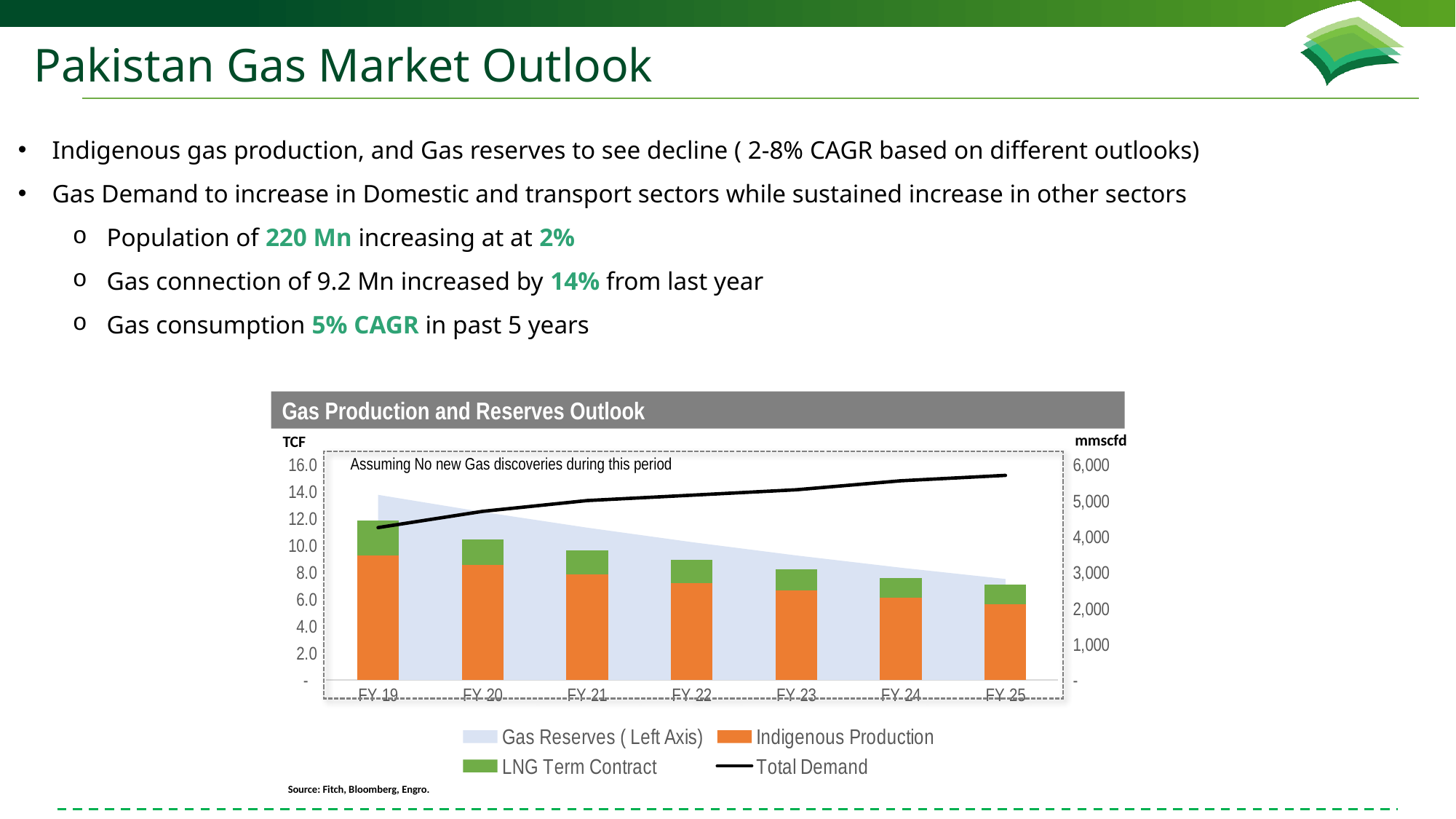
How many series does the chart legend list? 4 Does Indigenous Production rise or fall from FY 19 to FY 25? Fall What is the title of the chart on the slide? Gas Production and Reserves Outlook Does Total Demand rise or fall from FY 19 to FY 25? Rise What kind of chart is used to show Total Demand? Line chart What unit is shown on the left axis of the chart? TCF Is Total Demand in FY 25 greater or less than 5,000 mmscfd? greater In which fiscal year is Indigenous Production lowest? FY 25 In which fiscal year is Indigenous Production highest? FY 19 Is Gas Reserves in FY 19 greater or less than 12.0 TCF? greater What kind of chart is used to show Indigenous Production and LNG Term Contract? Stacked bar chart How many fiscal years are shown on the x axis of the chart? 7